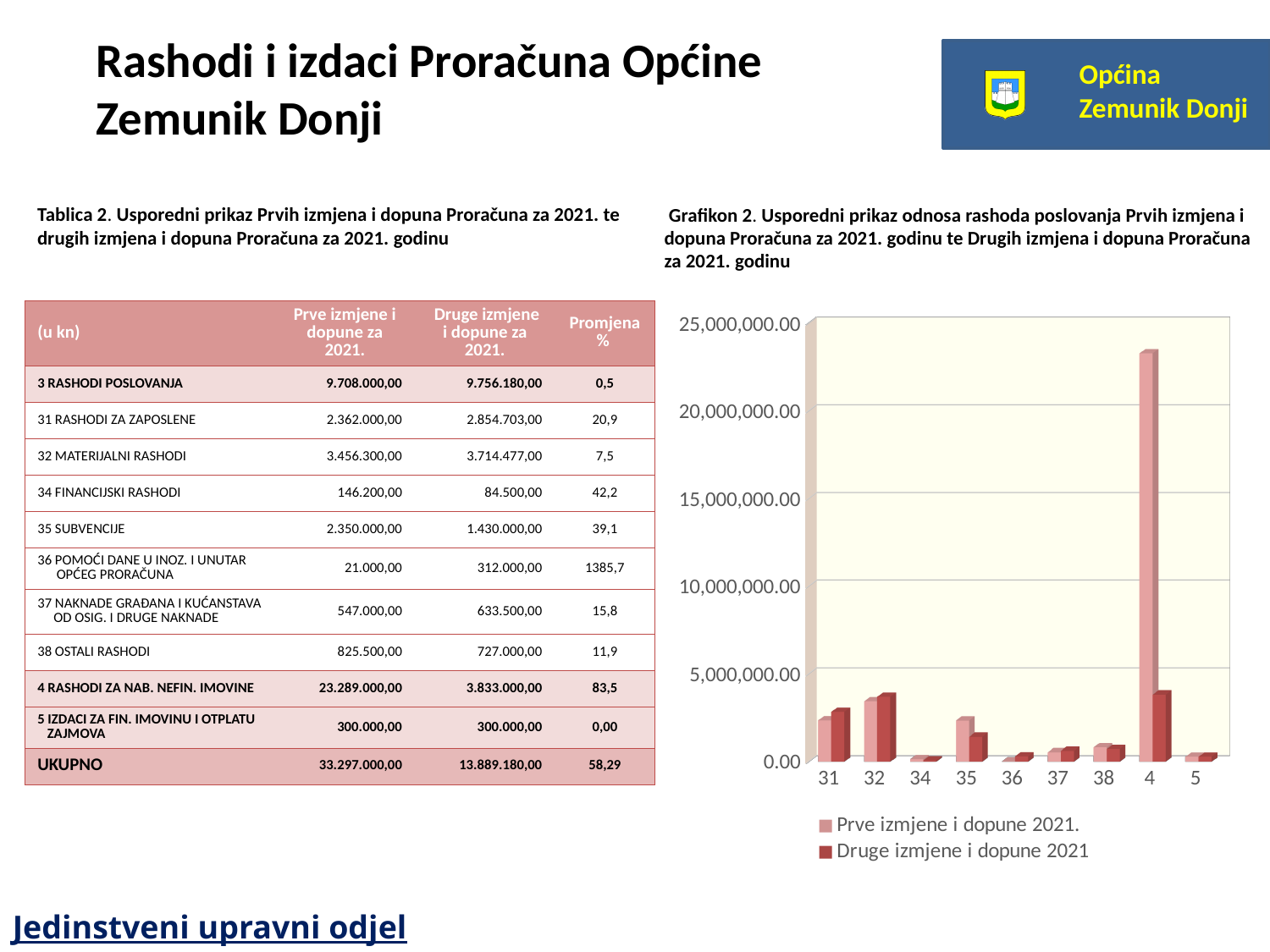
What kind of chart is Grafikon 2? bar chart In Grafikon 2, for category 35, which series has the larger value: Prve izmjene i dopune 2021. or Druge izmjene i dopune 2021? Prve izmjene i dopune 2021. In Grafikon 2, is the value for category 32 in the Prve izmjene i dopune 2021. series greater or less than 5,000,000.00? less In Grafikon 2, is the value for category 4 in the Prve izmjene i dopune 2021. series greater or less than 20,000,000.00? greater What are the two legend entries of Grafikon 2? Prve izmjene i dopune 2021. and Druge izmjene i dopune 2021 How many series does the legend of Grafikon 2 list? 2 How many categories are shown on the x axis of Grafikon 2? 9 In Grafikon 2, for category 4, which series has the larger value: Prve izmjene i dopune 2021. or Druge izmjene i dopune 2021? Prve izmjene i dopune 2021. In Grafikon 2, which category has the highest value for Prve izmjene i dopune 2021.? 4 In Grafikon 2, is the value for category 4 in the Druge izmjene i dopune 2021 series greater or less than 5,000,000.00? less In Grafikon 2, for category 36, which series has the larger value: Prve izmjene i dopune 2021. or Druge izmjene i dopune 2021? Druge izmjene i dopune 2021 In Grafikon 2, which category has the highest value for Druge izmjene i dopune 2021? 4